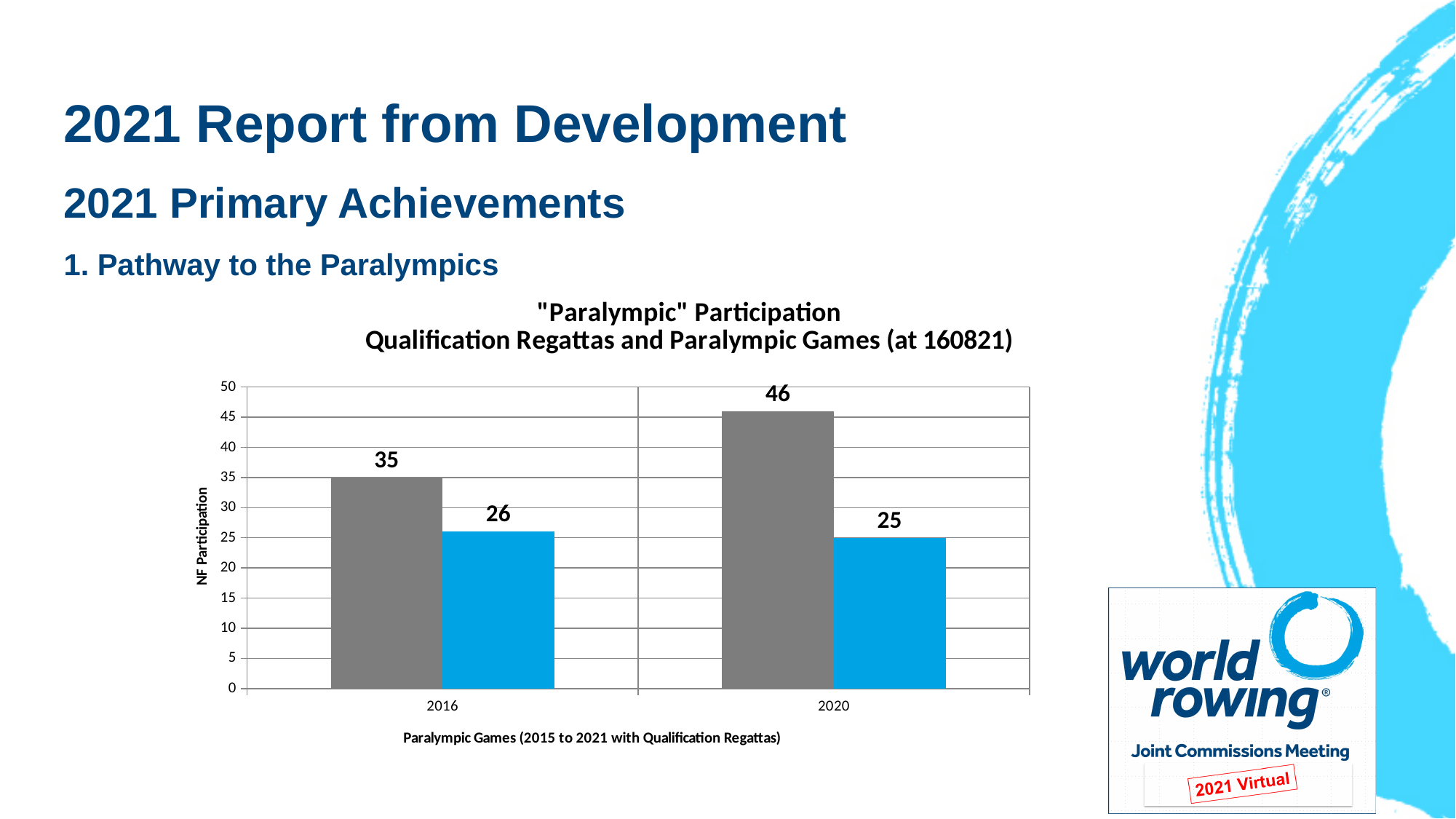
What is the value of the grey bar for 2020? 46 Which is larger, the blue bar for 2016 or the blue bar for 2020? The blue bar for 2016 What is the value of the blue bar for 2016? 26 How many year categories are shown on the x axis? 2 What type of chart is shown on the slide? Bar chart What is the difference between the grey and blue bars for 2016? 9 What is the difference between the grey bar values for 2020 and 2016? 11 Which bar has the highest value on the chart? The grey bar for 2020 (46) What is the value of the blue bar for 2020? 25 What is the label of the vertical axis? NF Participation What is the value of the grey bar for 2016? 35 Which bar has the lowest value on the chart? The blue bar for 2020 (25)